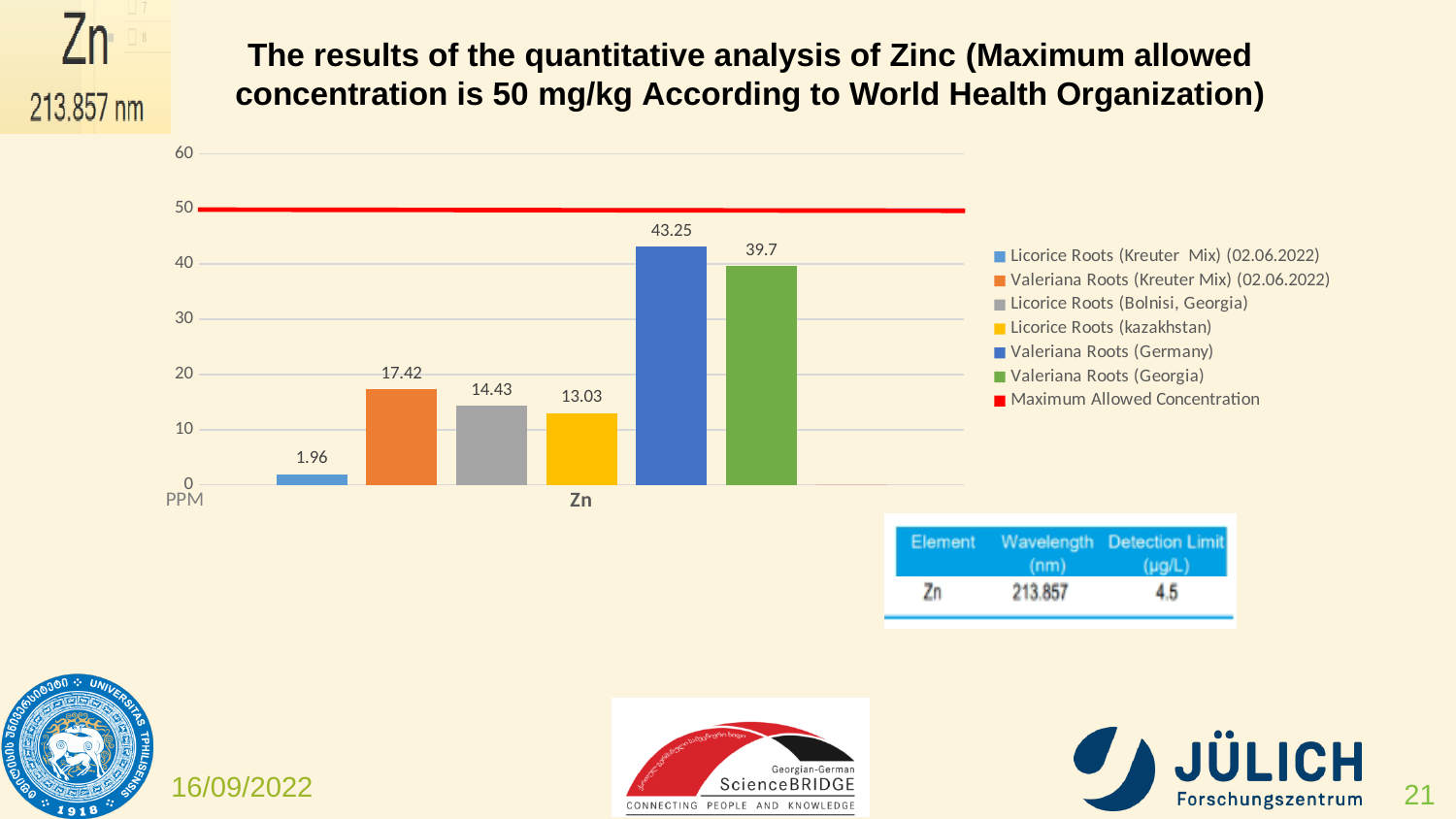
What is the value for Valeriana Roots (Germany)? 43.25 Which series has the lowest value? Licorice Roots (Kreuter Mix) (02.06.2022) What is the value for Licorice Roots (Kreuter Mix) (02.06.2022)? 1.96 What is the difference between the values for Valeriana Roots (Germany) and Valeriana Roots (Georgia)? 3.55 Which series has the highest value? Valeriana Roots (Germany) What kind of chart is shown on the slide? bar chart Which is larger, the value for Valeriana Roots (Kreuter Mix) (02.06.2022) or Licorice Roots (Bolnisi, Georgia)? Valeriana Roots (Kreuter Mix) (02.06.2022) How many entries does the legend list? 7 How many bars are plotted in the chart? 6 At what value is the red Maximum Allowed Concentration line drawn? 50 What is the value for Licorice Roots (kazakhstan)? 13.03 Is the value for Valeriana Roots (Georgia) greater or less than 50? less